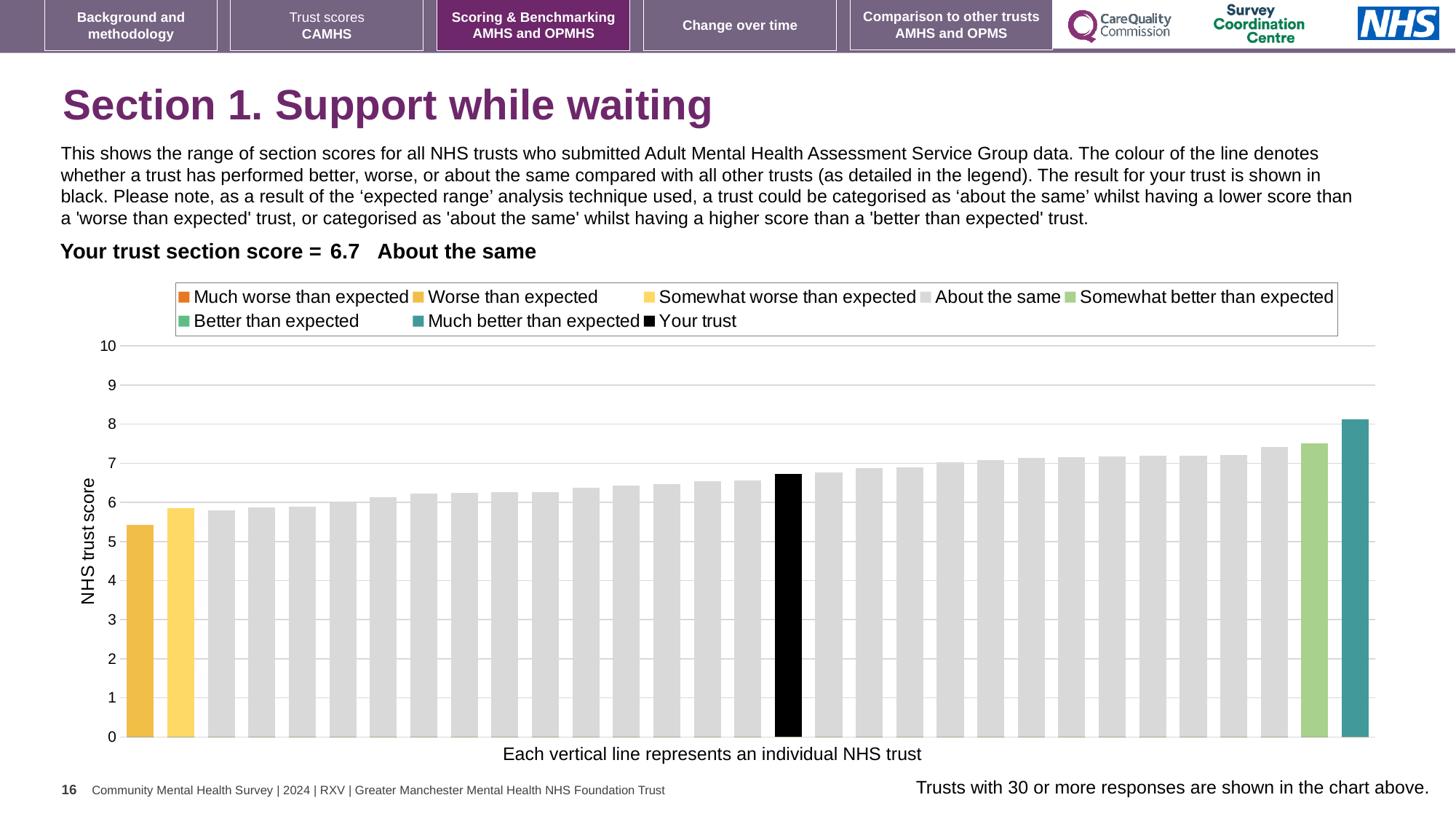
How many bars (NHS trusts) are plotted in the chart? 31 What is the label on the vertical axis of the chart? NHS trust score Is the value of the lowest bar in the chart greater or less than 6? less Is the value of the highest bar in the chart greater or less than 7? greater How is your trust categorised compared with other trusts? About the same Is the value for your trust (the black bar) greater or less than 6? greater Do the bar values rise or fall from left to right across the chart? rise What type of chart is shown on the slide? bar chart What colour is used to show your trust in the chart? black Which legend category does the highest bar in the chart belong to? Much better than expected How many entries does the chart legend list? 8 What is the section score for your trust shown on the slide? 6.7